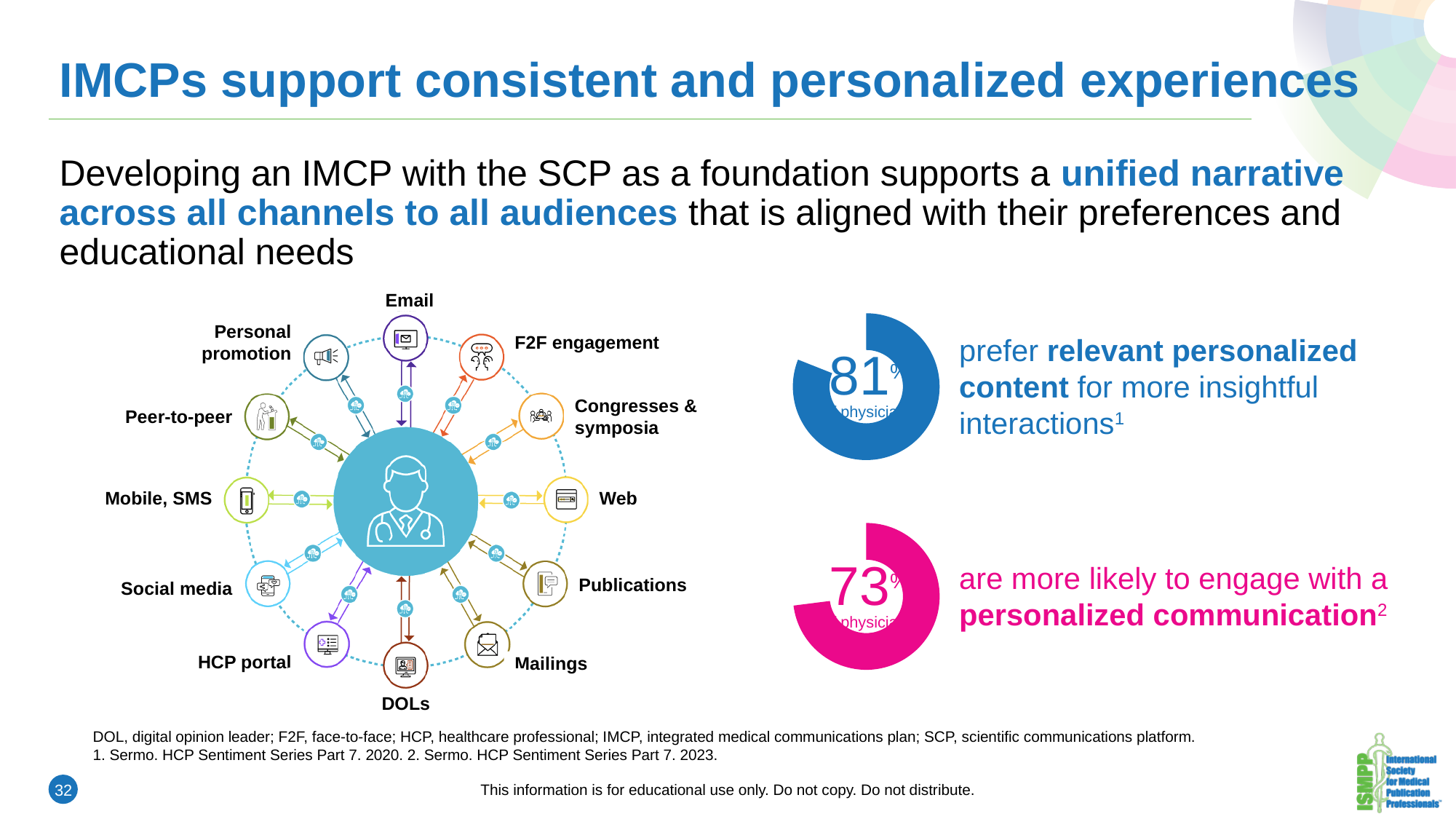
What is the difference in percentage points between the top donut chart value (81%) and the bottom donut chart value (73%)? 8 percentage points Which is larger: the percentage in the top donut chart (prefer relevant personalized content) or the percentage in the bottom donut chart (more likely to engage with personalized communication)? The top donut chart (81%) In the bottom donut chart, what share of the circle is filled to represent physicians more likely to engage with a personalized communication? 73% In the bottom donut chart, what percentage of physicians are more likely to engage with a personalized communication? 73% Is the value shown in the top donut chart greater or less than 80%? greater What kind of chart is used to show the 81% and 73% figures on the right side of the slide? Donut (pie) chart In the top donut chart, what share of the circle is filled to represent physicians who prefer relevant personalized content? 81% Is the value shown in the bottom donut chart greater or less than 75%? less What colour is the top donut chart showing 81%? Blue In the top donut chart, what percentage of physicians prefer relevant personalized content for more insightful interactions? 81% What colour is the bottom donut chart showing 73%? Pink (magenta) How many donut charts are shown on the right side of the slide? 2